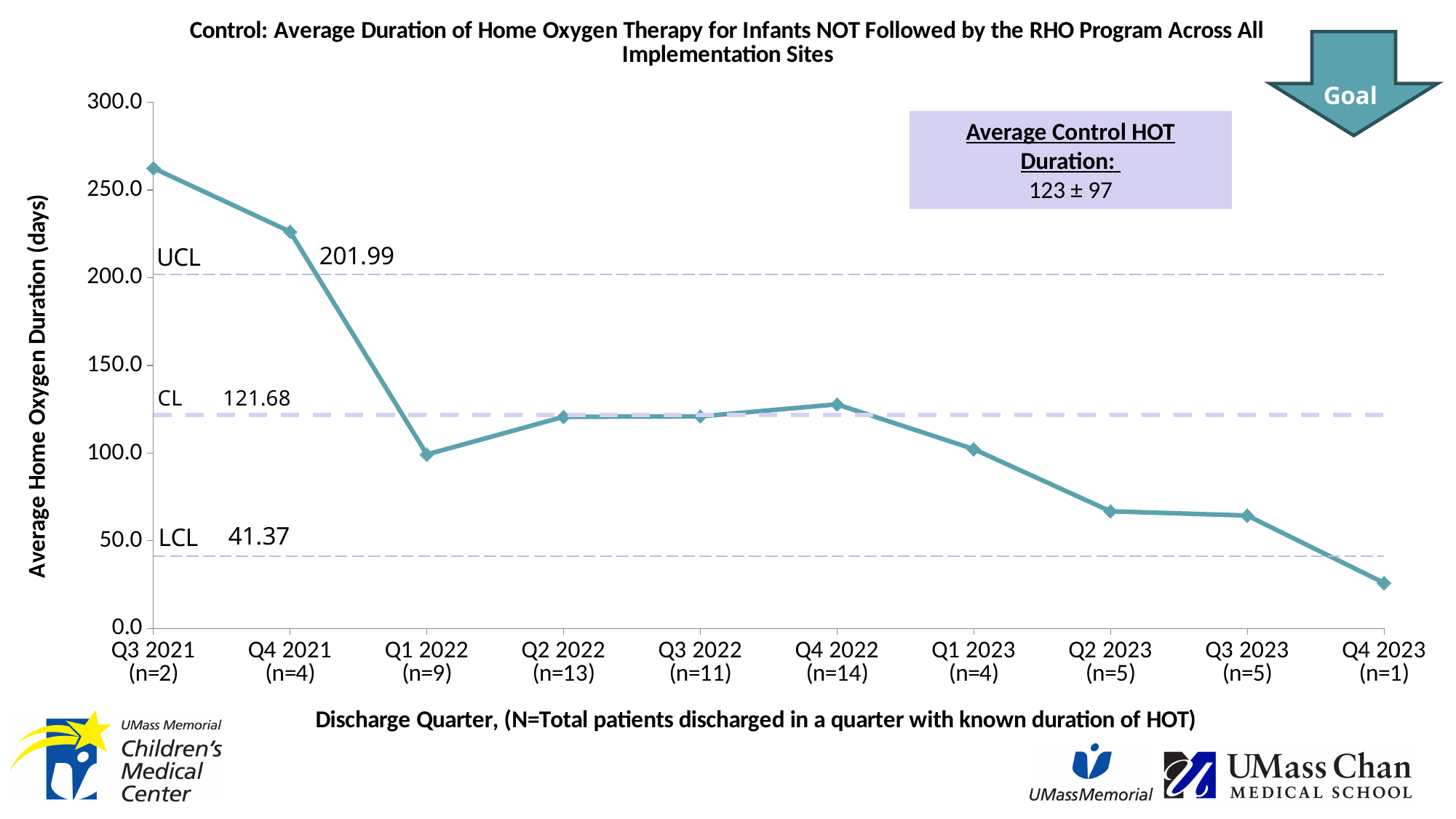
Which discharge quarter has the lowest average home oxygen duration? Q4 2023 Which is larger, the value for Q4 2022 or the value for Q1 2023? Q4 2022 What kind of chart is shown on the slide? line chart Overall, do the values rise or fall from Q3 2021 to Q4 2023? fall What is the value of the CL line? 121.68 Is the value for Q2 2023 greater or less than 100? less How many discharge quarters are plotted on the x axis? 10 What is the value of the LCL line? 41.37 Is the value for Q3 2021 greater or less than 250? greater Is the value for Q4 2023 greater or less than 50? less Which discharge quarter has the highest average home oxygen duration? Q3 2021 What is the value of the UCL line? 201.99